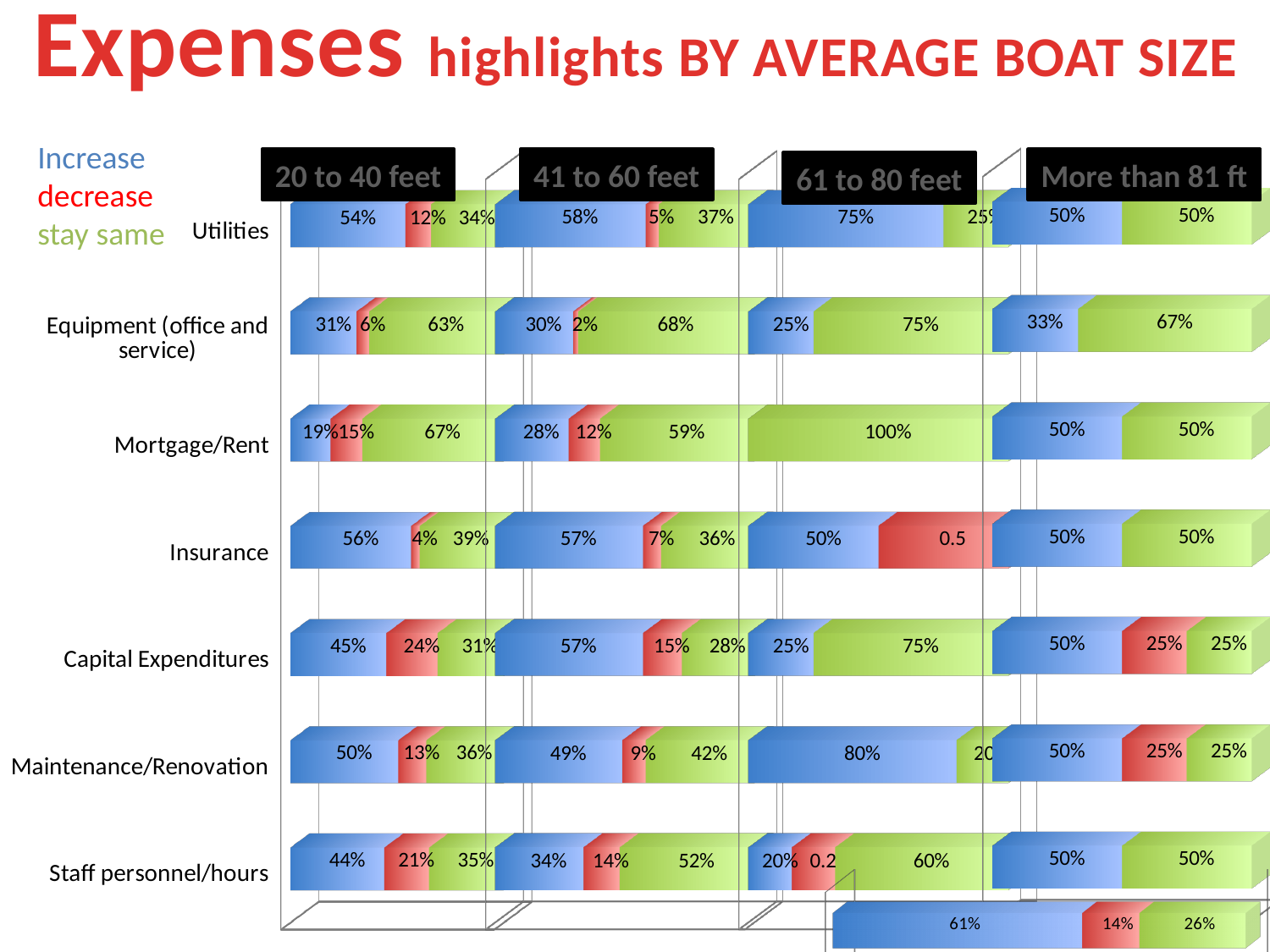
In the More than 81 ft chart, what percentage reported a decrease in Capital Expenditures? 25% In the 61 to 80 feet chart, what percentage said Mortgage/Rent would stay the same? 100% In the 41 to 60 feet chart, which is larger: the stay same percentage for Equipment (office and service) or for Mortgage/Rent? Equipment (office and service) How many expense categories are listed on the slide? 7 What kind of chart is used on this slide? Stacked bar chart In the 20 to 40 feet chart, which category has the lowest Increase percentage? Mortgage/Rent In the 41 to 60 feet chart, what percentage said Staff personnel/hours would stay the same? 52% How many series does the legend list? 3 Which colour represents 'stay same' in the charts? Green In the 20 to 40 feet chart, what is the difference between the Increase and decrease percentages for Utilities? 42% In the 20 to 40 feet chart, which category has the highest Increase percentage? Insurance In the 20 to 40 feet chart, what percentage of respondents reported an increase in Utilities? 54%